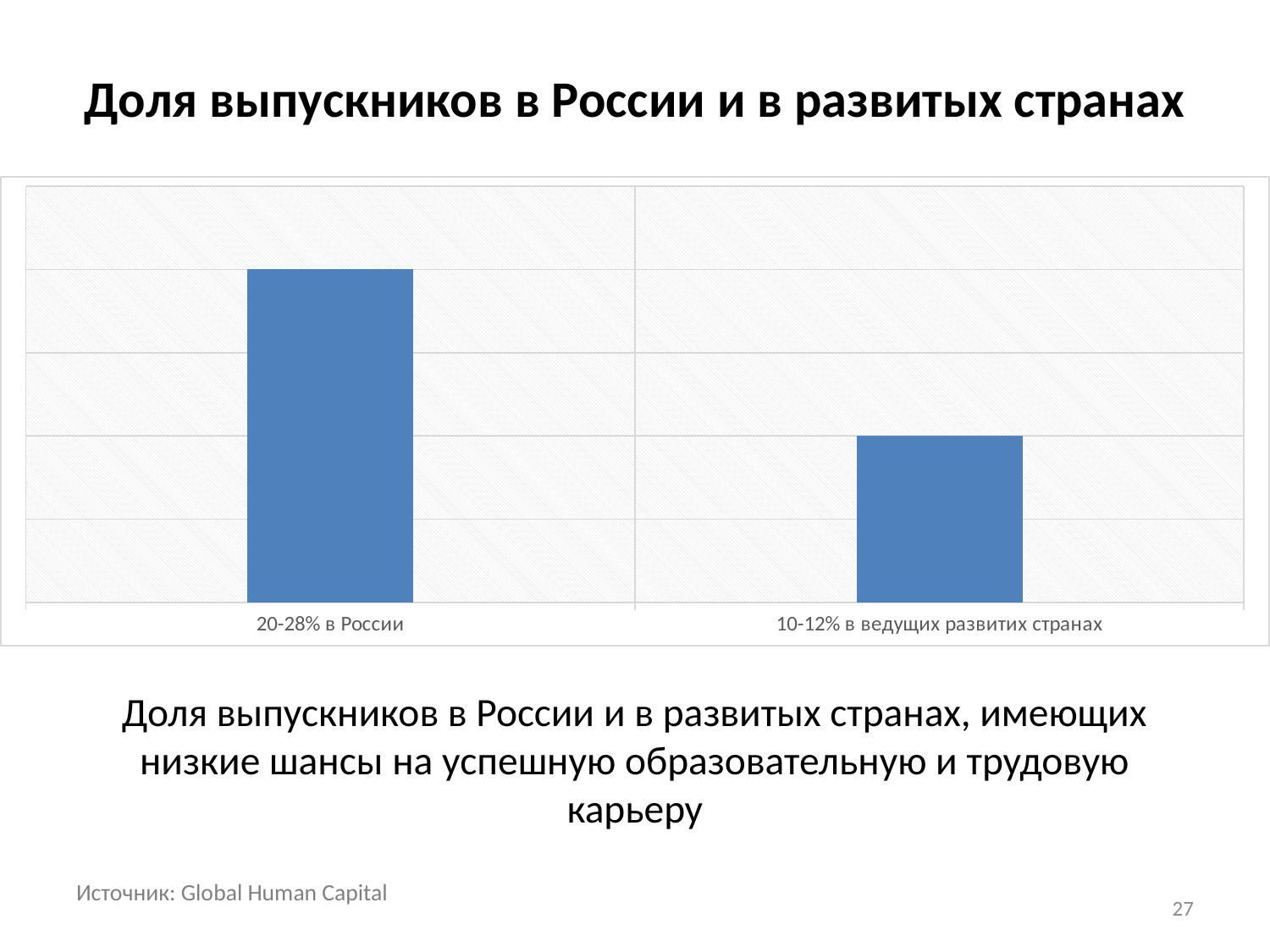
Which bar is taller: "20-28% в России" or "10-12% в ведущих развитых странах"? 20-28% в России What kind of chart is shown on the slide? bar chart What source is cited for the chart? Global Human Capital Which category has the lowest bar? 10-12% в ведущих развитих странах What is the title of the slide containing the chart? Доля выпускников в России и в развитых странах Which category has the highest bar? 20-28% в России How many bars are plotted in the chart? 2 Do the bar values rise or fall from left to right along the x axis? fall